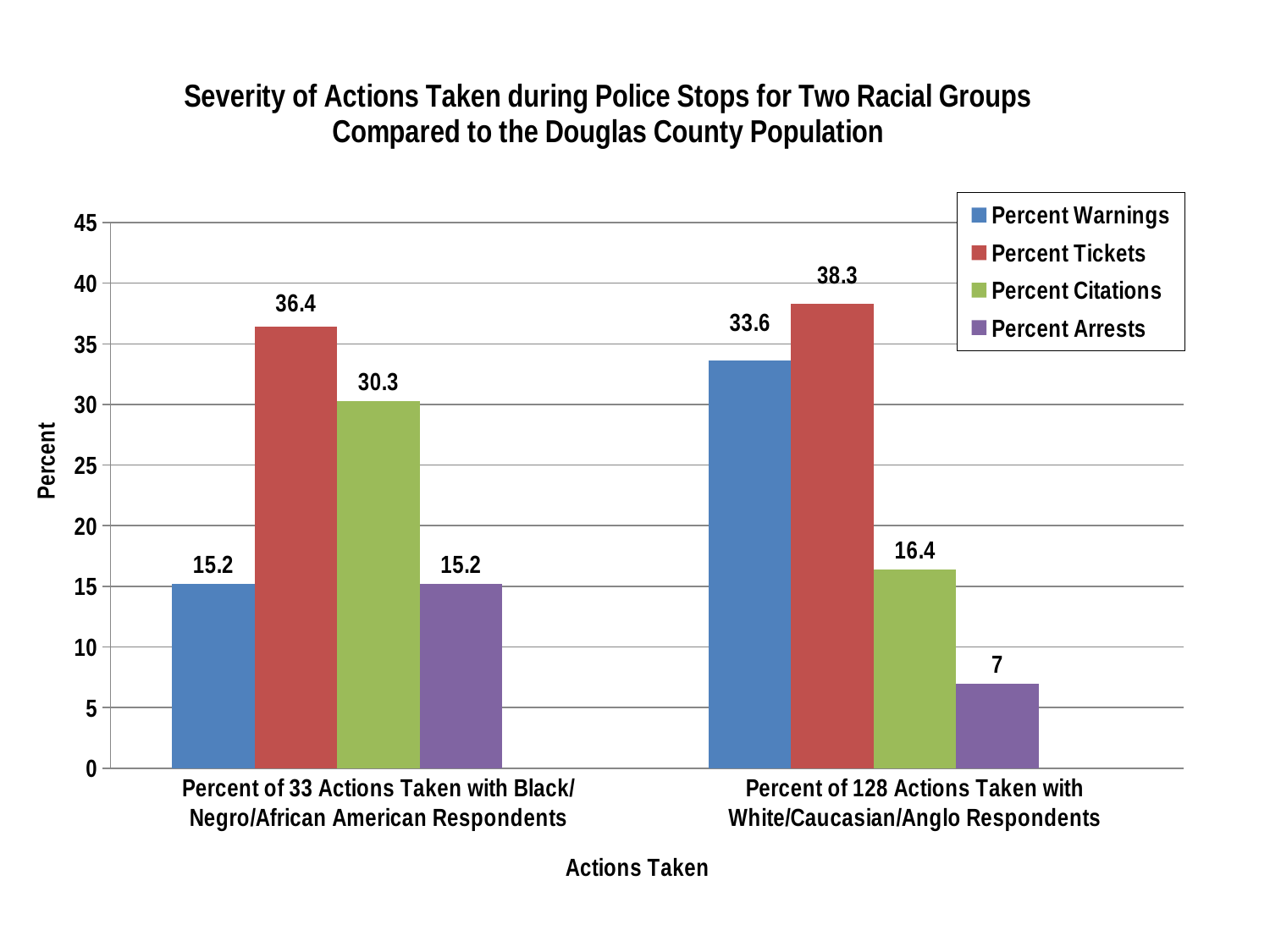
What is the Percent Arrests value for the White/Caucasian/Anglo respondents group? 7 How many categories are shown on the x axis? 2 Which series has the highest value for the White/Caucasian/Anglo respondents group? Percent Tickets What is the Percent Citations value for the White/Caucasian/Anglo respondents group? 16.4 How many series does the legend list? 4 What is the difference between Percent Citations for the Black/Negro/African American group and Percent Citations for the White/Caucasian/Anglo group? 13.9 What is the Percent Warnings value for the Black/Negro/African American respondents group? 15.2 What kind of chart is shown on the slide? Bar chart What is the Percent Tickets value for the Black/Negro/African American respondents group? 36.4 What is the label of the y axis? Percent Which is larger: Percent Warnings for the Black/Negro/African American group or Percent Warnings for the White/Caucasian/Anglo group? Percent Warnings for the White/Caucasian/Anglo group Which series has the lowest value for the White/Caucasian/Anglo respondents group? Percent Arrests